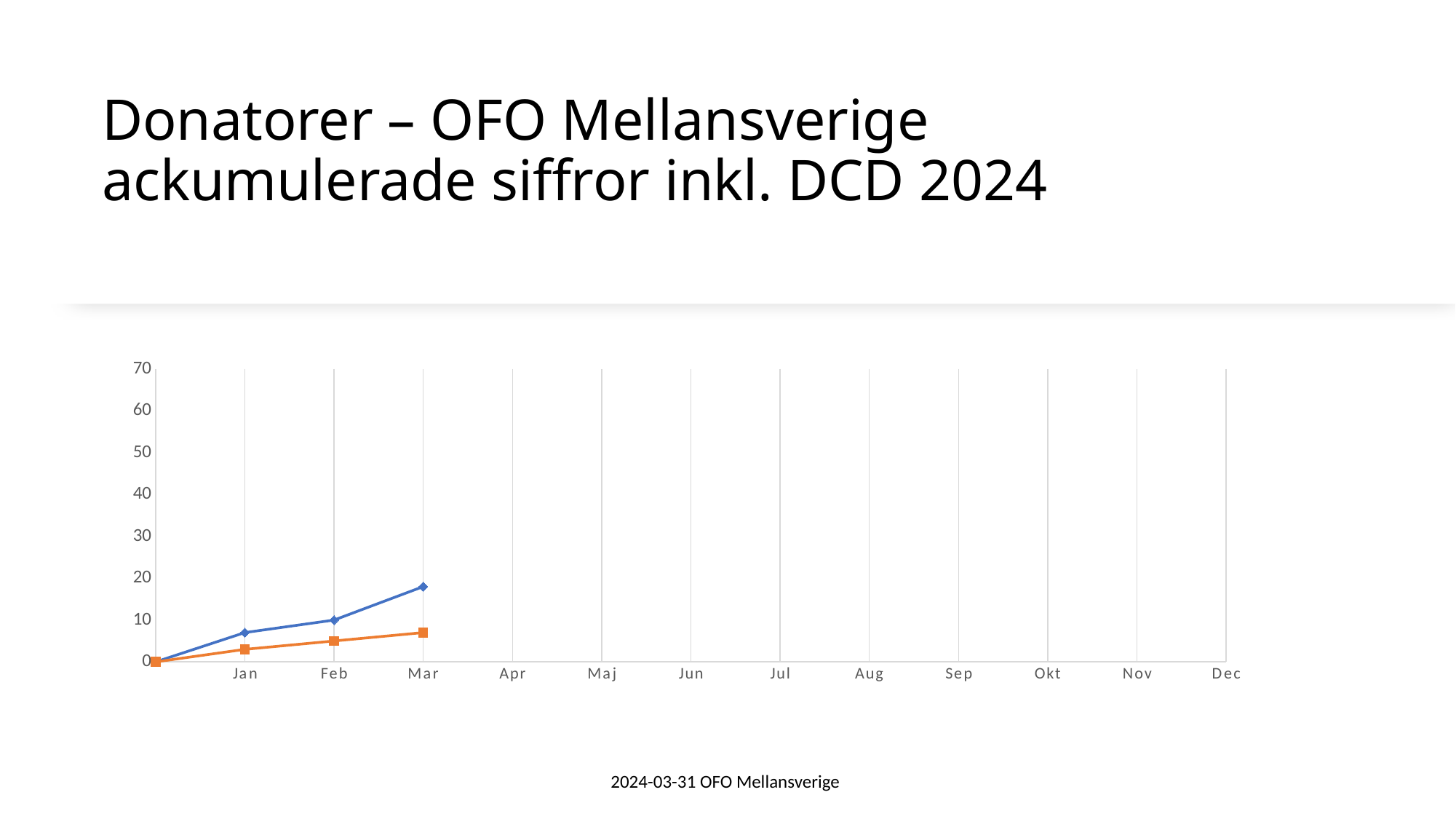
What kind of chart is shown on the slide? line chart How many month labels are shown on the x axis? 12 How many lines (series) are plotted on the chart? 2 Among the labelled months with data, in which month does the blue line reach its highest value? Mar Is the value of the blue line at Mar greater or less than 10? greater What is the last month on the x axis for which data points are plotted? Mar At Mar, which line has the higher value, the blue line or the orange line? the blue line Is the value of the orange line at Mar greater or less than 10? less Does the blue line rise or fall from Jan to Mar? rise Is the value of the blue line at Mar greater or less than 20? less Among the labelled months with data, in which month is the orange line at its lowest value? Jan